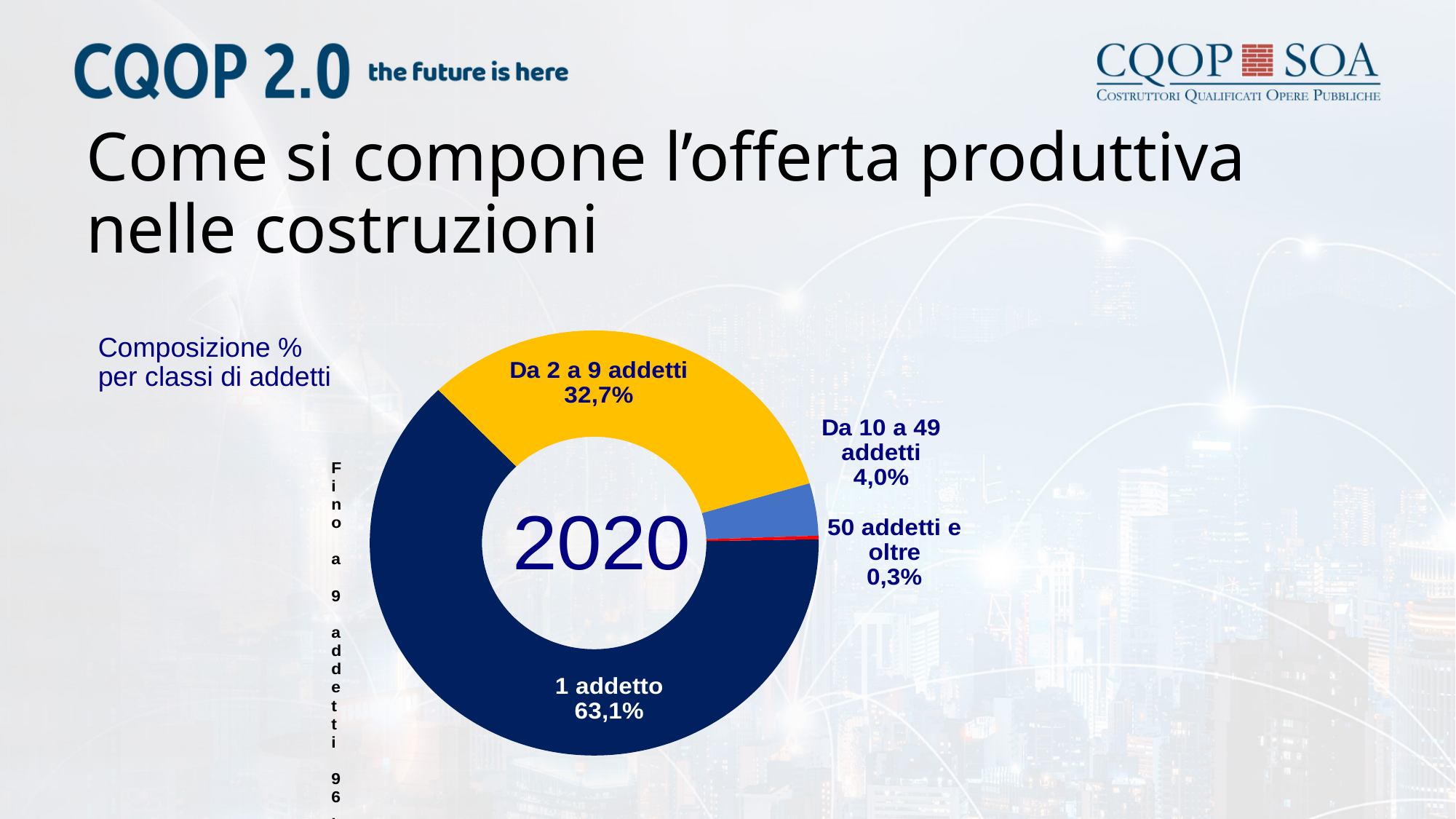
What kind of chart is shown on the slide? Doughnut (pie) chart What percentage is shown for "Da 10 a 49 addetti"? 4,0% What colour is the slice for "Da 2 a 9 addetti"? Yellow What year is written in the centre of the doughnut chart? 2020 What share of the doughnut chart is labelled "1 addetto"? 63,1% Which class of addetti has the smallest share in the chart? 50 addetti e oltre What percentage is shown for "Da 2 a 9 addetti"? 32,7% Which is larger: the share for "Da 10 a 49 addetti" or for "50 addetti e oltre"? Da 10 a 49 addetti How many classes of addetti are shown in the chart? 4 Which class of addetti has the largest share in the chart? 1 addetto What is the difference in percentage points between "1 addetto" and "Da 2 a 9 addetti"? 30,4 What percentage is shown for "50 addetti e oltre"? 0,3%